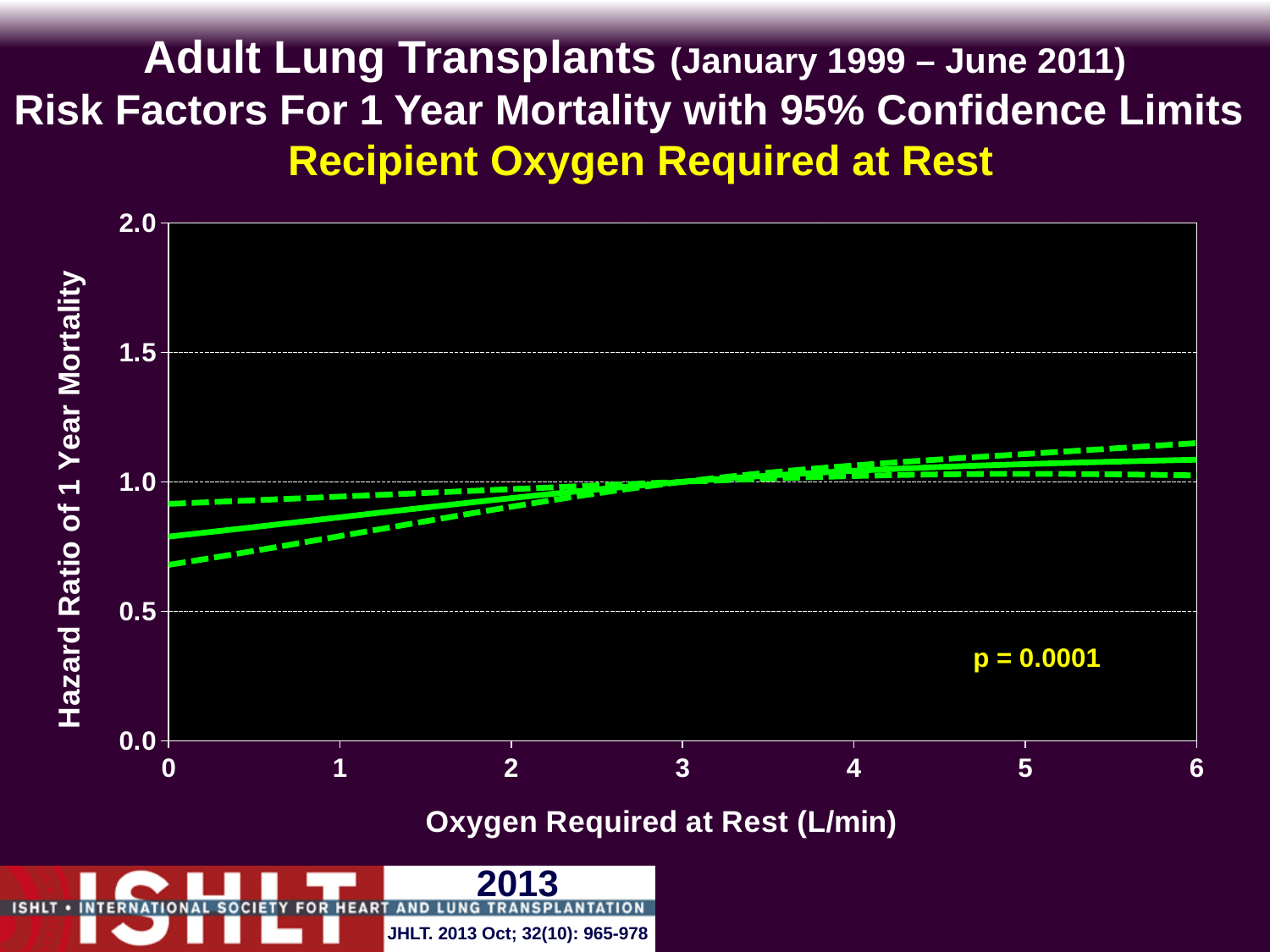
Does the hazard ratio rise or fall as oxygen required at rest increases from 0 to 6 L/min? rise What p-value is shown on the chart? p = 0.0001 Is the upper 95% confidence limit at 0 L/min greater or less than 1.0? less Is the hazard ratio (solid line) at 0 L/min greater or less than 1.0? less What kind of chart is shown on the slide? line chart What is the title of the x axis? Oxygen Required at Rest (L/min) How many lines are plotted on the chart? 3 Is the hazard ratio (solid line) at 0 L/min greater or less than 0.5? greater